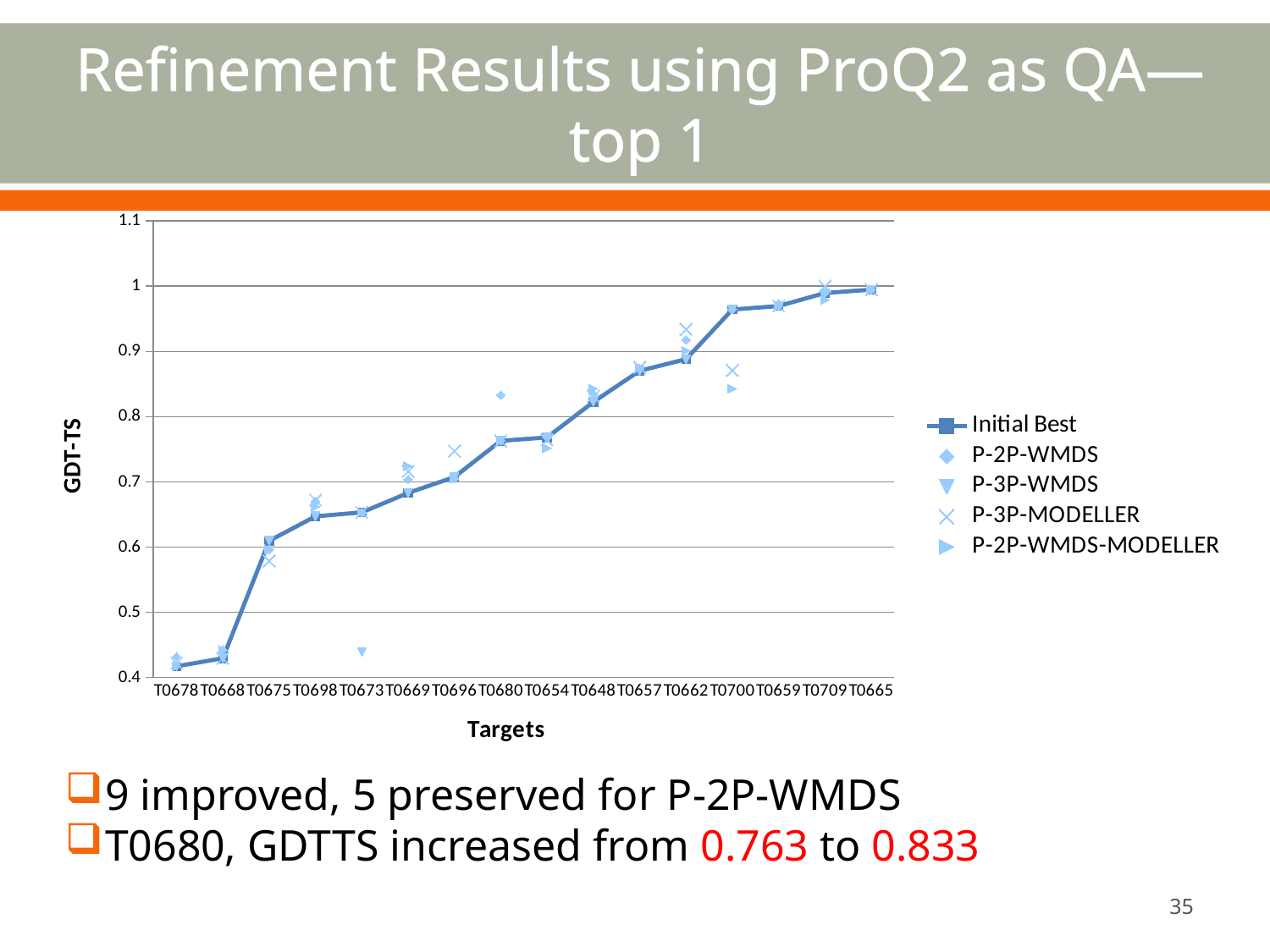
Do the Initial Best values rise or fall moving from T0678 to T0665 along the x axis? rise Which series is drawn as a connected line with square markers? Initial Best Is the Initial Best value for T0665 greater or less than 0.9? greater Is the Initial Best value for T0680 greater or less than 0.7? greater Is the Initial Best value for T0678 greater or less than 0.5? less What kind of chart is shown on the slide? line chart Which target has the larger Initial Best value, T0668 or T0698? T0698 How many series does the chart legend list? 5 How many targets are listed along the x axis of the chart? 16 What is the label of the y axis? GDT-TS According to the slide, what was the GDTTS for T0680 before and after refinement? 0.763 to 0.833